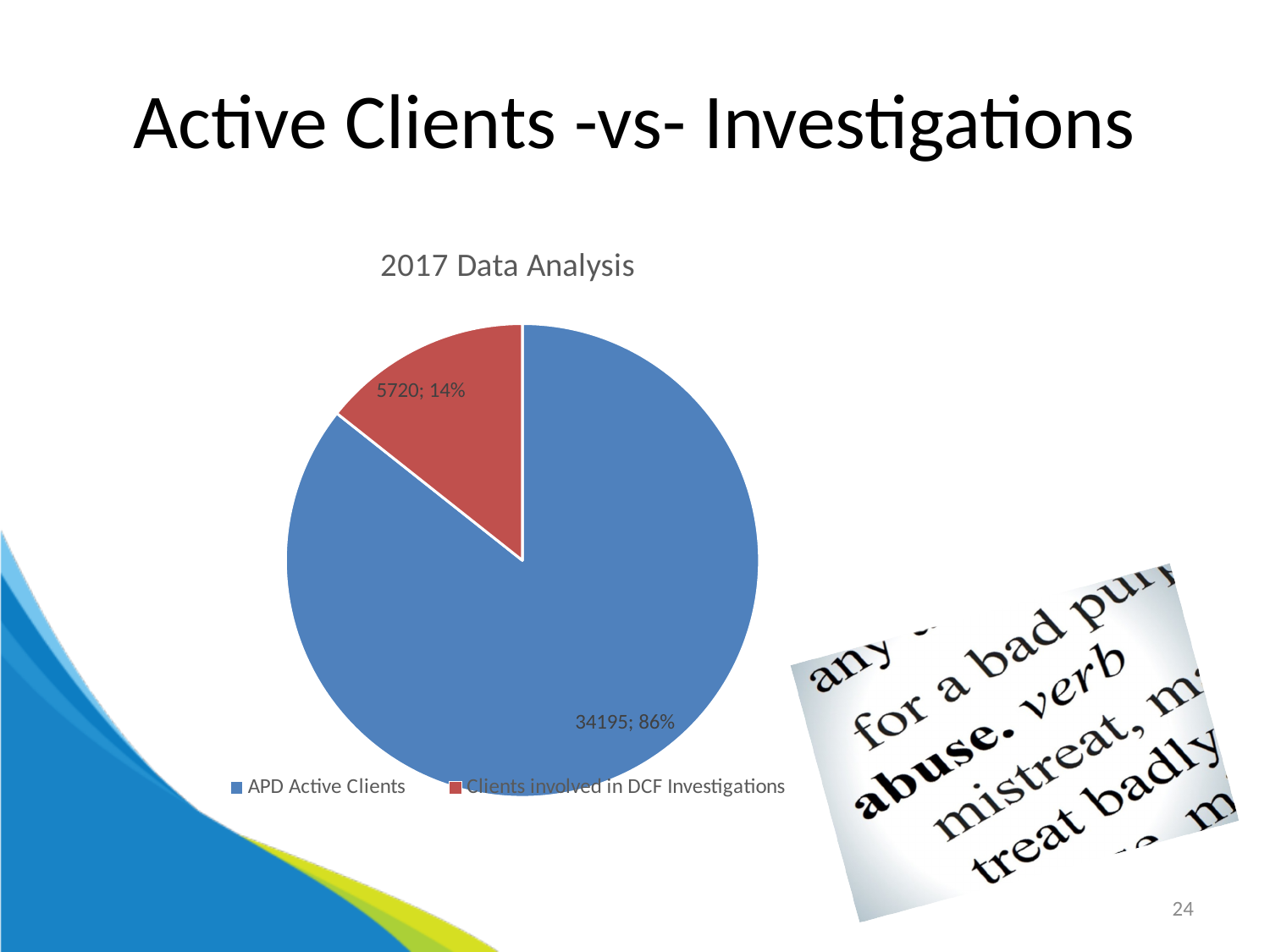
What is the difference between the values for APD Active Clients and Clients involved in DCF Investigations? 28475 What is the value for Clients involved in DCF Investigations? 5720 What colour is the slice for Clients involved in DCF Investigations? red What kind of chart is shown on the slide? pie chart What is the value for APD Active Clients? 34195 How many slices does the pie chart have? 2 What share of the pie is Clients involved in DCF Investigations? 14% Which is larger, APD Active Clients or Clients involved in DCF Investigations? APD Active Clients What is the title of the chart? 2017 Data Analysis What share of the pie is APD Active Clients? 86% Which category has the largest slice? APD Active Clients Which category has the smallest slice? Clients involved in DCF Investigations